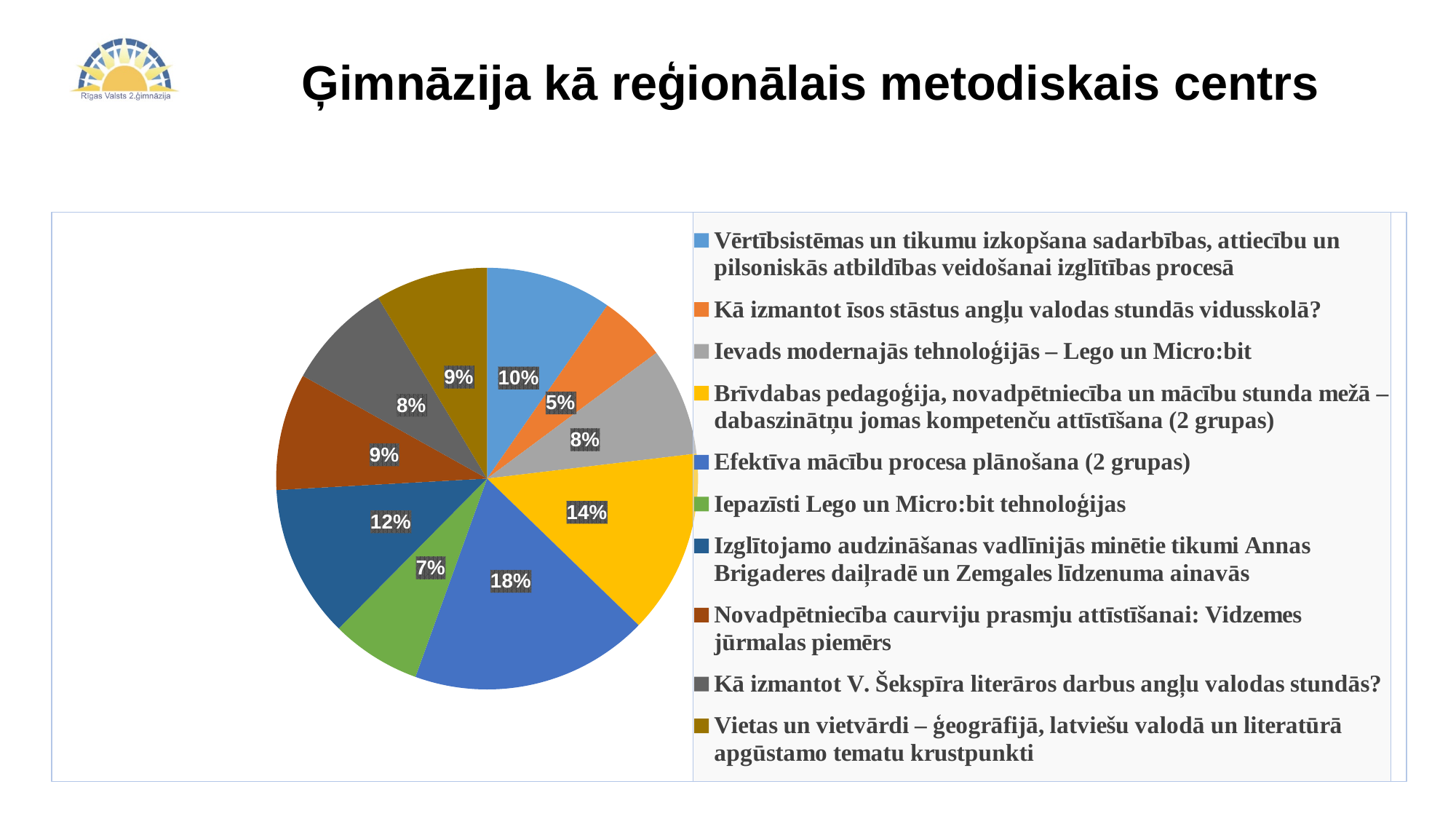
What share of the pie does "Kā izmantot īsos stāstus angļu valodas stundās vidusskolā?" have? 5% What is the value shown for "Brīvdabas pedagoģija, novadpētniecība un mācību stunda mežā – dabaszinātņu jomas kompetenču attīstīšana (2 grupas)"? 14% What kind of chart is shown on the slide? pie chart What colour is the slice for "Iepazīsti Lego un Micro:bit tehnoloģijas"? green What is the value shown for "Iepazīsti Lego un Micro:bit tehnoloģijas"? 7% Which category has the largest slice of the pie? Efektīva mācību procesa plānošana (2 grupas) What share of the pie does "Efektīva mācību procesa plānošana (2 grupas)" have? 18% How many slices does the pie chart have? 10 Which is larger: the share for "Vērtībsistēmas un tikumu izkopšana sadarbības, attiecību un pilsoniskās atbildības veidošanai izglītības procesā" or for "Iepazīsti Lego un Micro:bit tehnoloģijas"? Vērtībsistēmas un tikumu izkopšana sadarbības, attiecību un pilsoniskās atbildības veidošanai izglītības procesā What is the value shown for "Izglītojamo audzināšanas vadlīnijās minētie tikumi Annas Brigaderes daiļradē un Zemgales līdzenuma ainavās"? 12% What is the difference between the shares for "Efektīva mācību procesa plānošana (2 grupas)" and "Brīvdabas pedagoģija, novadpētniecība un mācību stunda mežā – dabaszinātņu jomas kompetenču attīstīšana (2 grupas)"? 4% Which category has the smallest slice of the pie? Kā izmantot īsos stāstus angļu valodas stundās vidusskolā?